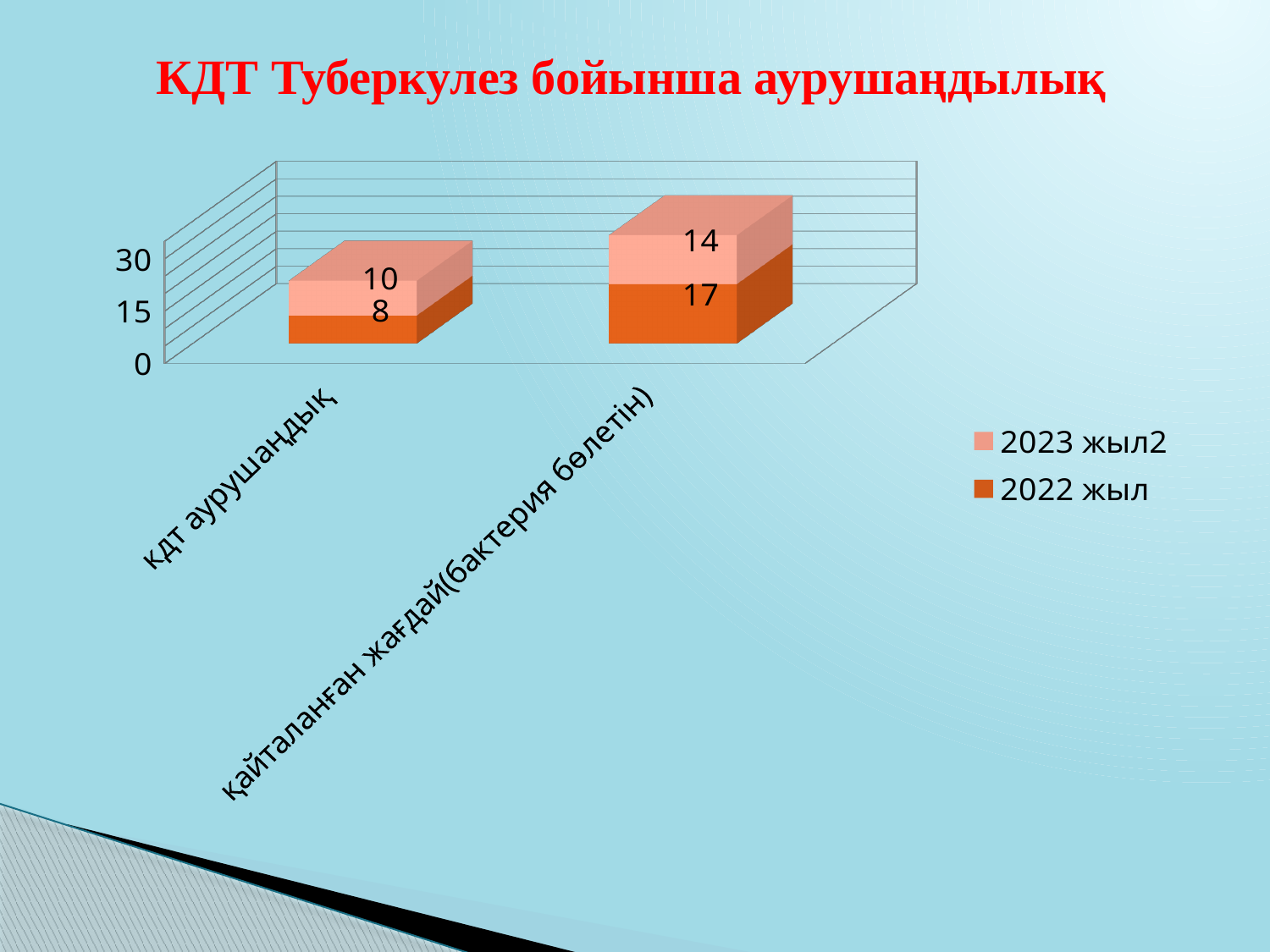
What is the difference between the 2022 жыл values for қайталанған жағдай(бактерия бөлетін) and кдт аурушаңдық? 9 What type of chart is shown on the slide? Stacked bar chart Which category has the higher 2023 жыл2 value? қайталанған жағдай(бактерия бөлетін) What is the total of the stacked bar for кдт аурушаңдық? 18 How many series does the legend list? 2 In the қайталанған жағдай(бактерия бөлетін) category, which series has the larger value, 2022 жыл or 2023 жыл2? 2022 жыл What is the value for 2023 жыл2 in the қайталанған жағдай(бактерия бөлетін) category? 14 What is the value for 2022 жыл in the қайталанған жағдай(бактерия бөлетін) category? 17 How many categories are shown on the chart? 2 What is the total of the stacked bar for қайталанған жағдай(бактерия бөлетін)? 31 What is the value for 2022 жыл in the кдт аурушаңдық category? 8 What is the value for 2023 жыл2 in the кдт аурушаңдық category? 10